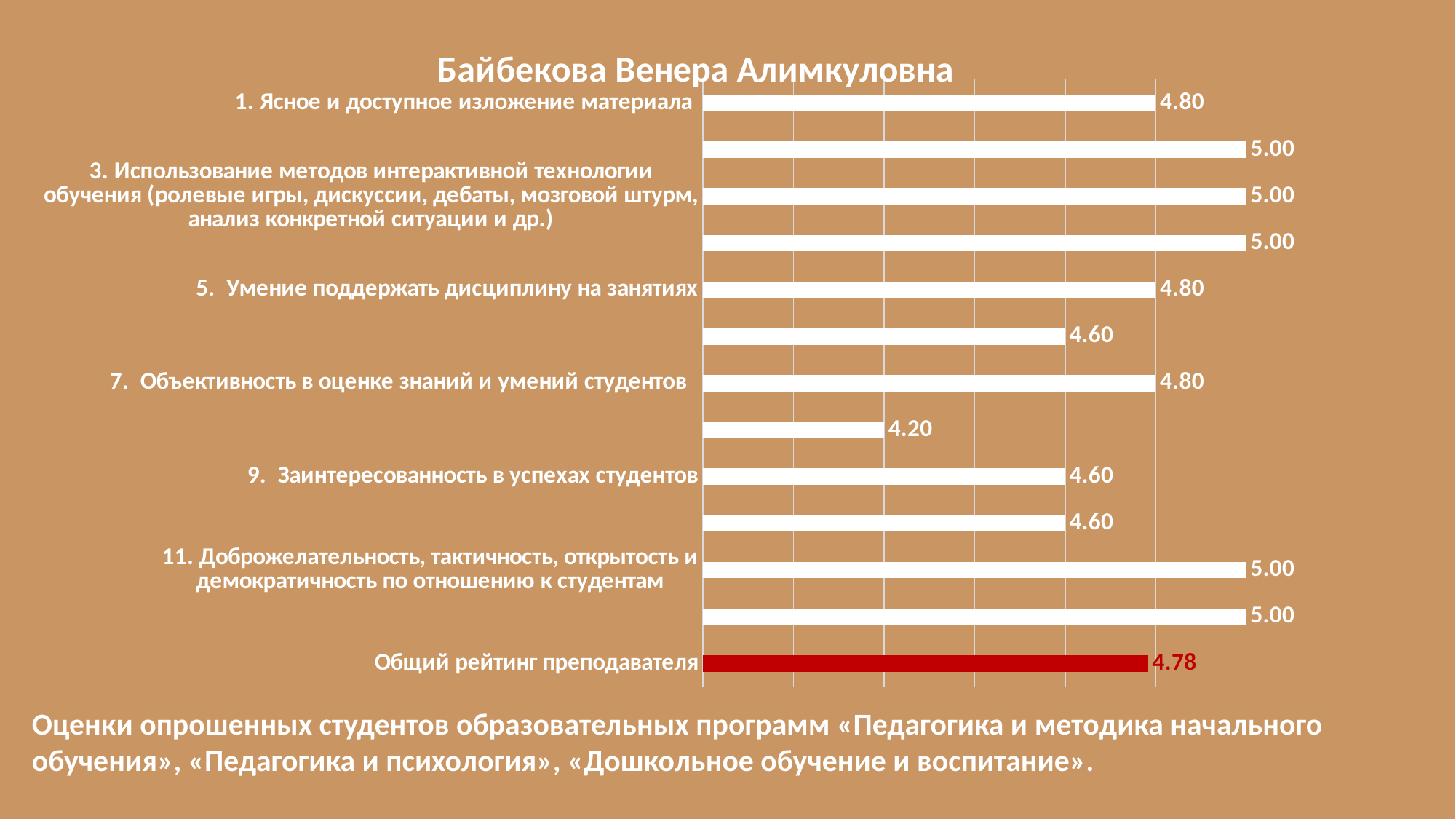
What is the value for '11. Доброжелательность, тактичность, открытость и демократичность по отношению к студентам'? 5.00 How many bars are plotted on the chart? 13 What is the highest value shown on the chart? 5.00 What is the value for '1. Ясное и доступное изложение материала'? 4.80 What colour is the bar for 'Общий рейтинг преподавателя'? Red What is the value for '9. Заинтересованность в успехах студентов'? 4.60 What is the lowest value shown on the chart? 4.20 What is the value for '5. Умение поддержать дисциплину на занятиях'? 4.80 What is the value for 'Общий рейтинг преподавателя'? 4.78 Which is larger: the value for '7. Объективность в оценке знаний и умений студентов' or the value for '9. Заинтересованность в успехах студентов'? 7. Объективность в оценке знаний и умений студентов What kind of chart is shown on the slide? Bar chart What is the difference between the value for '1. Ясное и доступное изложение материала' and the value for '9. Заинтересованность в успехах студентов'? 0.20